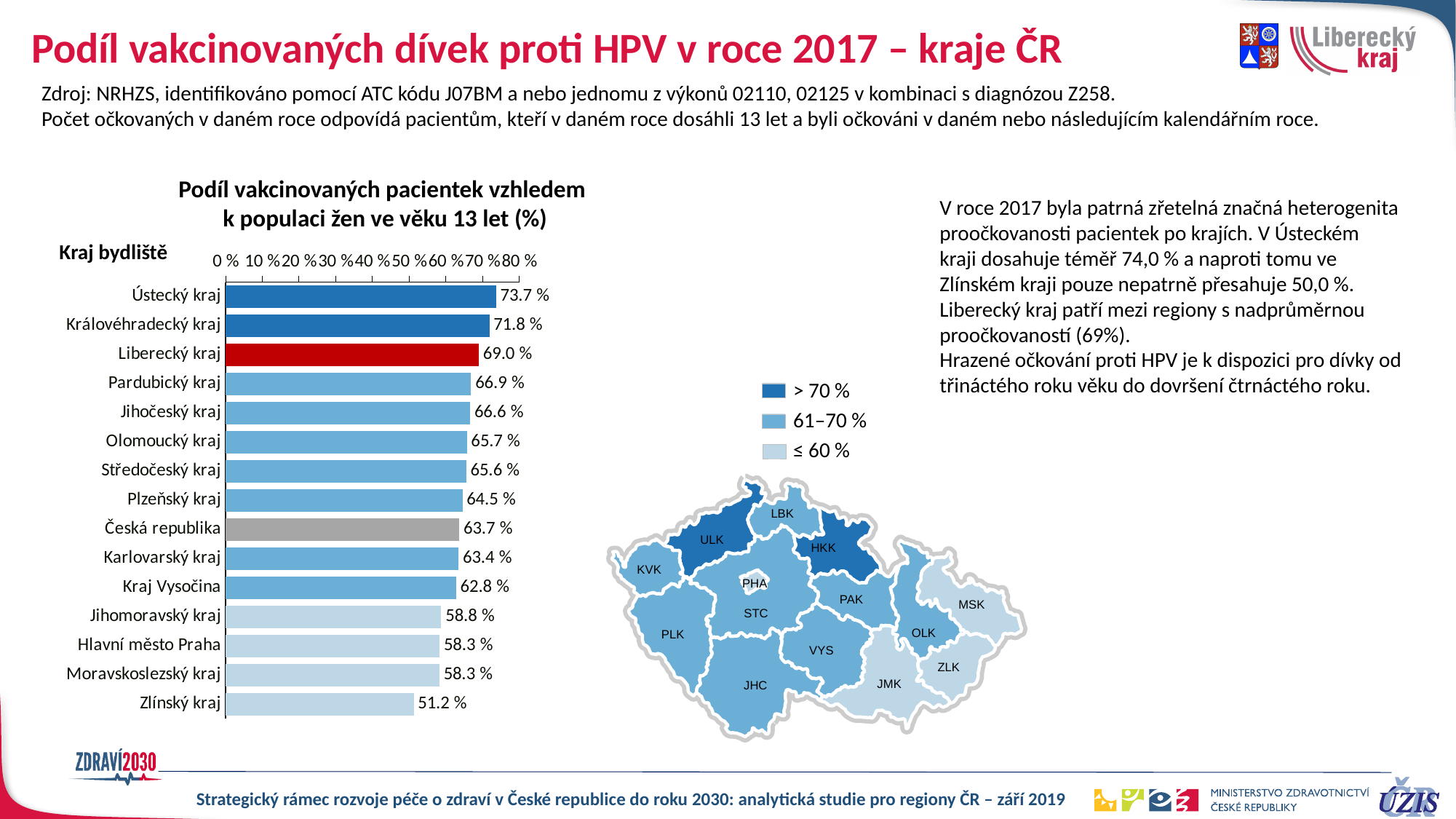
What is the value for Česká republika? 63.7 % What is the difference between the values for Liberecký kraj and Česká republika? 5.3 % Which category has the highest value? Ústecký kraj What is the difference between the values for Ústecký kraj and Zlínský kraj? 22.5 % What kind of chart is shown on the slide? bar chart Which category has the lowest value? Zlínský kraj What is the value for Ústecký kraj? 73.7 % What colour is the bar for Liberecký kraj? red How many bars are shown in the chart? 15 Which is larger, the value for Pardubický kraj or the value for Jihočeský kraj? Pardubický kraj Is the value for Karlovarský kraj greater or less than 60 %? greater What is the value for Liberecký kraj? 69.0 %